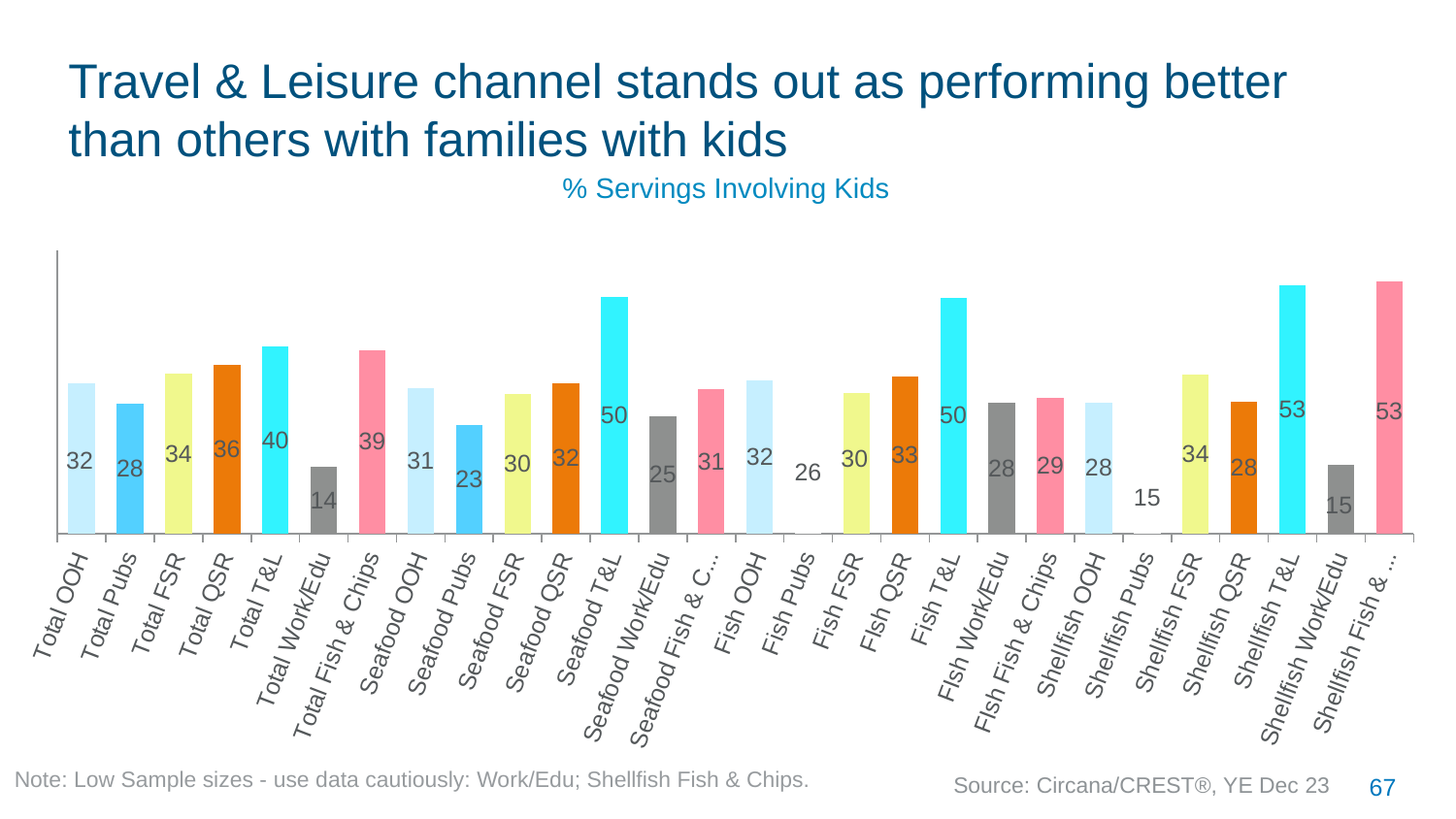
Which category has the lowest value on the chart? Total Work/Edu How many categories are shown on the chart? 28 What is the difference between the values for Total T&L and Total Pubs? 12 What is the value for Total Work/Edu? 14 What is the value for Fish QSR? 33 What is the value for Shellfish T&L? 53 Which is larger, the value for Total Fish & Chips or the value for Total OOH? Total Fish & Chips What is the value for Total T&L? 40 What kind of chart is shown on the slide? Bar chart What is the value for Seafood Pubs? 23 What is the difference between the values for Seafood T&L and Seafood FSR? 20 Which is larger, the value for Fish T&L or the value for Fish Work/Edu? Fish T&L